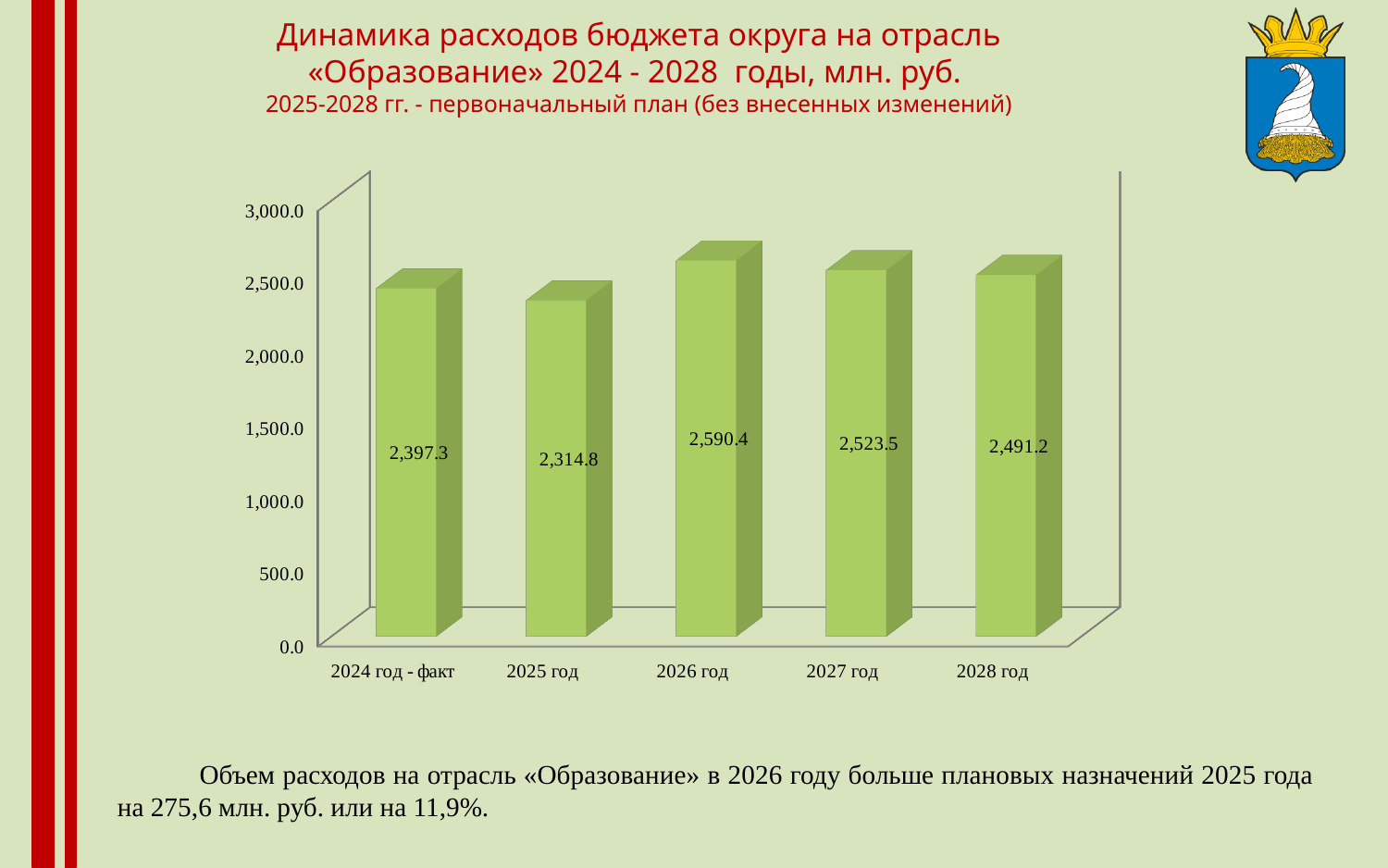
What is the value for 2026 год? 2,590.4 What is the difference between the values for 2027 год and 2028 год? 32.3 What is the difference between the values for 2026 год and 2025 год? 275.6 Which year has the lowest value? 2025 год Do the values rise or fall from 2026 год to 2028 год? fall How many categories are shown on the x axis? 5 Which year has the highest value? 2026 год Is the value for 2027 год greater or less than 2,500.0? greater What kind of chart is shown on the slide? bar chart What is the value for 2024 год - факт? 2,397.3 Which is larger, the value for 2024 год - факт or the value for 2025 год? 2024 год - факт What is the value for 2028 год? 2,491.2